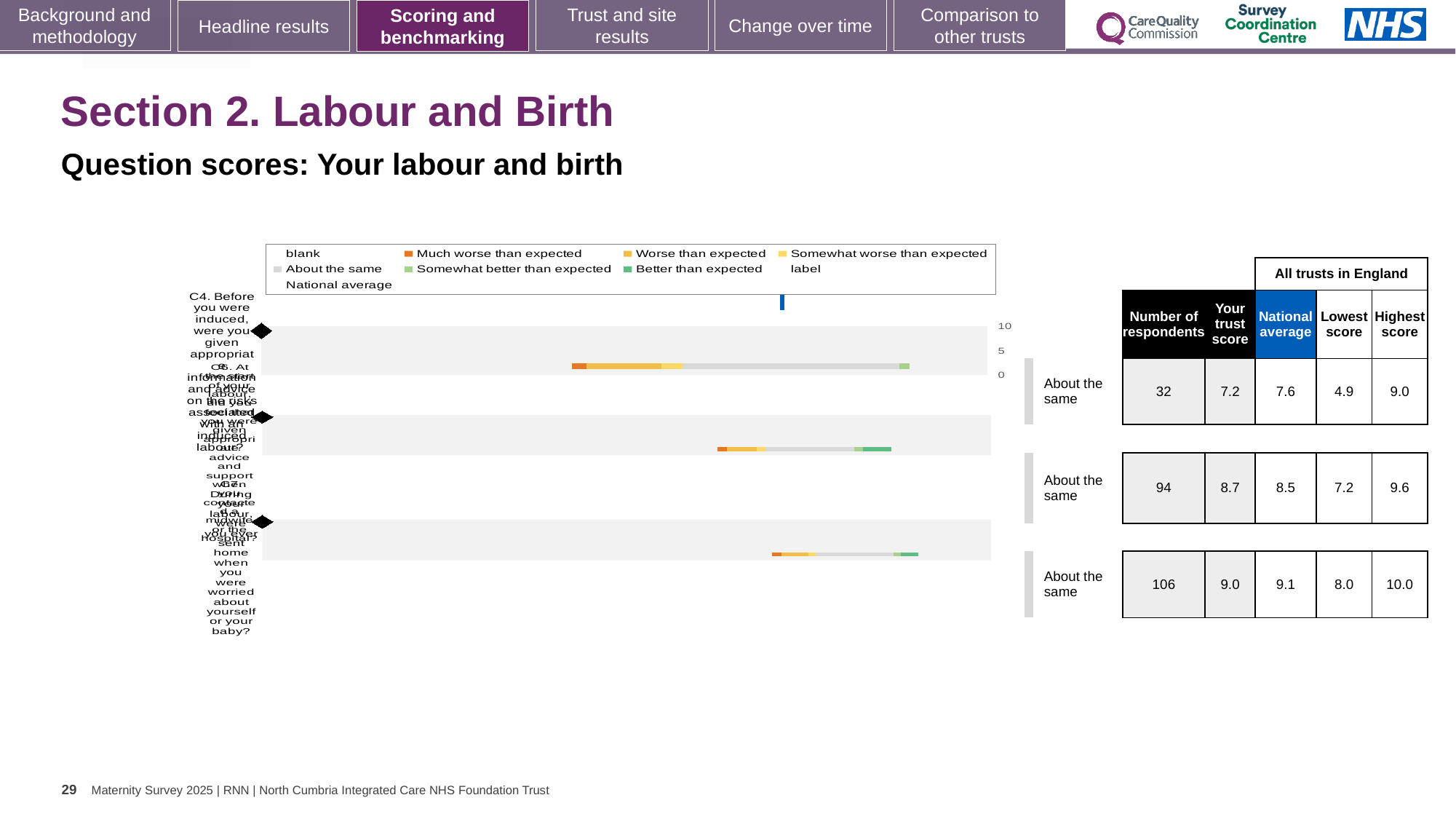
In the table beside the chart, which row has the highest trust score? the third row (9.0) In the table beside the chart, what is the highest score for the third row? 10.0 What kind of chart is shown on the slide? bar chart In the table beside the chart, what is the national average for the second row? 8.5 How many bars (question rows) does the chart show? 3 Which legend entry is shown in dark orange? Much worse than expected In the table beside the chart, what is the trust score for the first row? 7.2 In the table beside the chart, what is the difference between the trust score and the national average in the second row? 0.2 How many entries does the chart's legend list? 9 In the table beside the chart, what is the number of respondents for the first row? 32 In the table beside the chart, is the trust score for the first row larger or smaller than the national average? smaller Which legend entry is shown in dark green? Better than expected